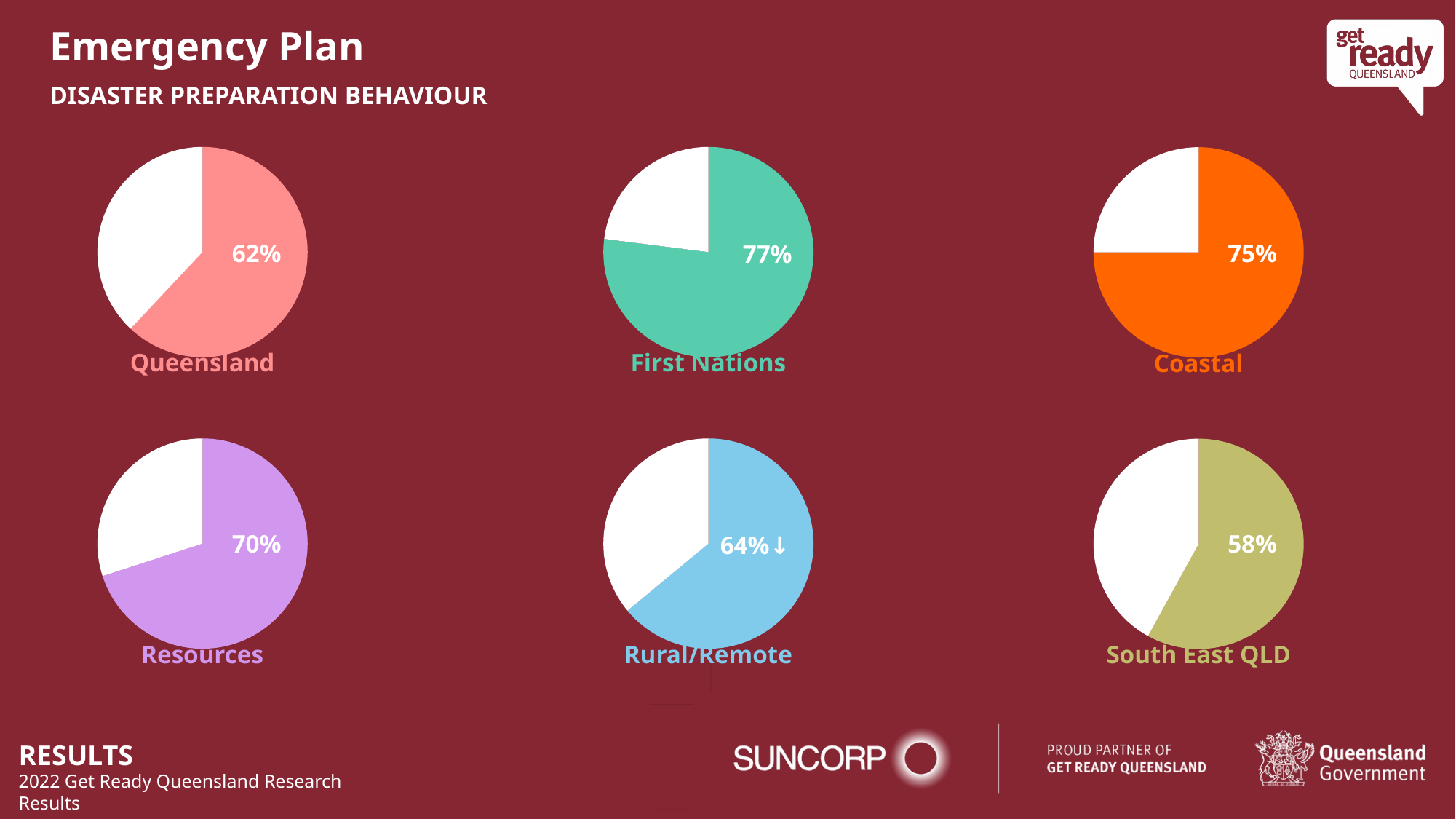
What percentage is shown on the South East QLD pie chart? 58% How many pie charts are on the slide? 6 Which is larger, the Coastal percentage or the Resources percentage? Coastal What percentage is shown on the Coastal pie chart? 75% Which group's pie chart shows the lowest percentage? South East QLD What percentage is shown on the Rural/Remote pie chart? 64% What percentage is shown on the First Nations pie chart? 77% Which group's pie chart shows the highest percentage? First Nations What is the difference between the First Nations percentage and the South East QLD percentage? 19% What kind of chart is used to show each group's percentage on the slide? Pie chart What percentage is shown on the Resources pie chart? 70% What percentage is shown on the Queensland pie chart? 62%